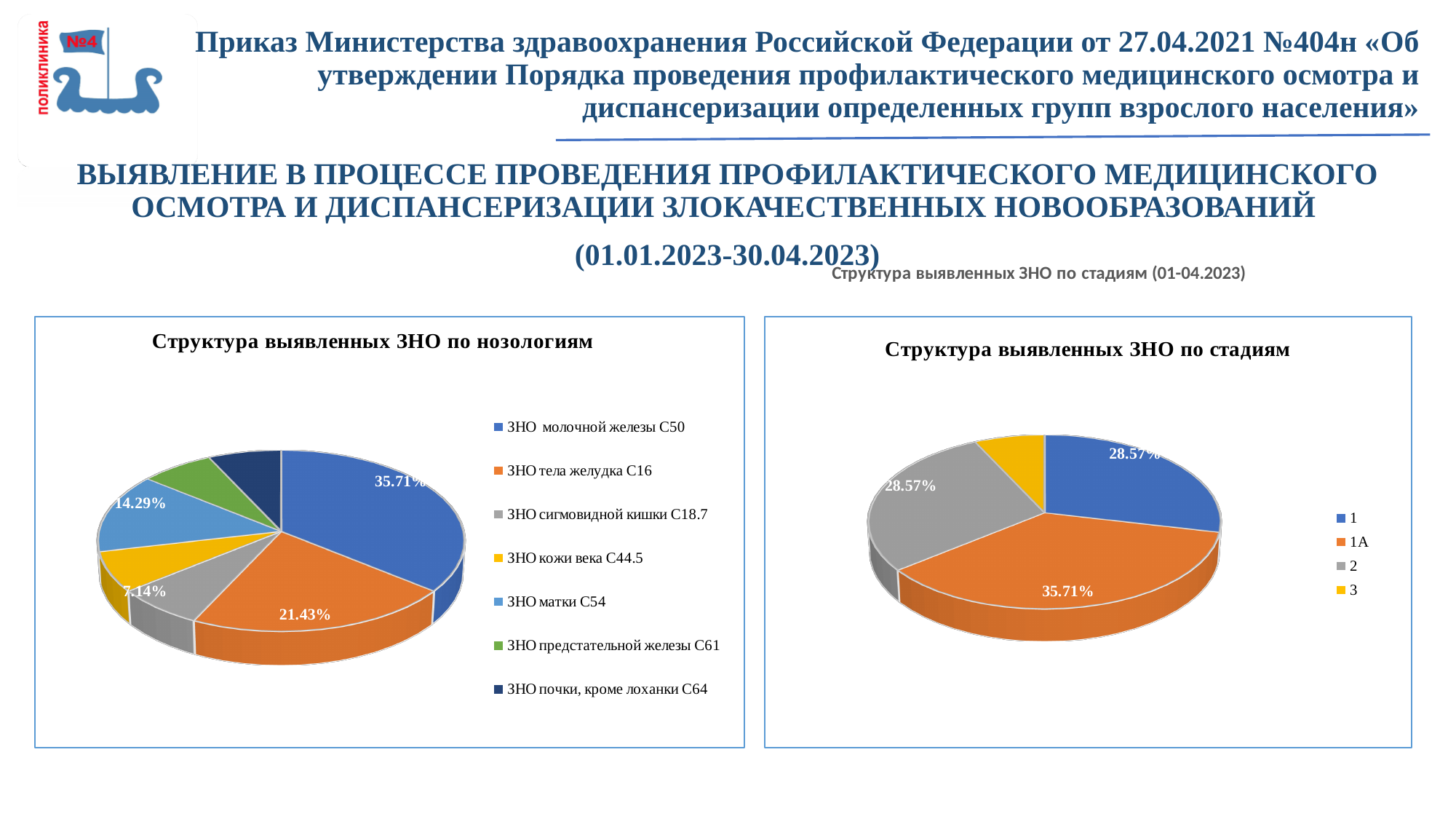
In the right chart "Структура выявленных ЗНО по стадиям", which stage has the smallest slice? 3 In the left chart "Структура выявленных ЗНО по нозологиям", which category has the largest slice? ЗНО молочной железы C50 In the left chart "Структура выявленных ЗНО по нозологиям", which is larger: ЗНО тела желудка C16 or ЗНО матки C54? ЗНО тела желудка C16 How many stages does the legend of the right chart "Структура выявленных ЗНО по стадиям" list? 4 In the right chart "Структура выявленных ЗНО по стадиям", what share is shown for stage 2? 28.57% In the left chart "Структура выявленных ЗНО по нозологиям", what share is shown for ЗНО молочной железы C50? 35.71% How many categories does the legend of the left chart "Структура выявленных ЗНО по нозологиям" list? 7 In the right chart "Структура выявленных ЗНО по стадиям", what share is shown for stage 1A? 35.71% What kind of chart is the left chart titled "Структура выявленных ЗНО по нозологиям"? pie chart In the left chart "Структура выявленных ЗНО по нозологиям", what share is shown for ЗНО матки C54? 14.29% In the left chart "Структура выявленных ЗНО по нозологиям", what is the difference between the shares of ЗНО молочной железы C50 and ЗНО тела желудка C16? 14.28% In the left chart "Структура выявленных ЗНО по нозологиям", what share is shown for ЗНО тела желудка C16? 21.43%